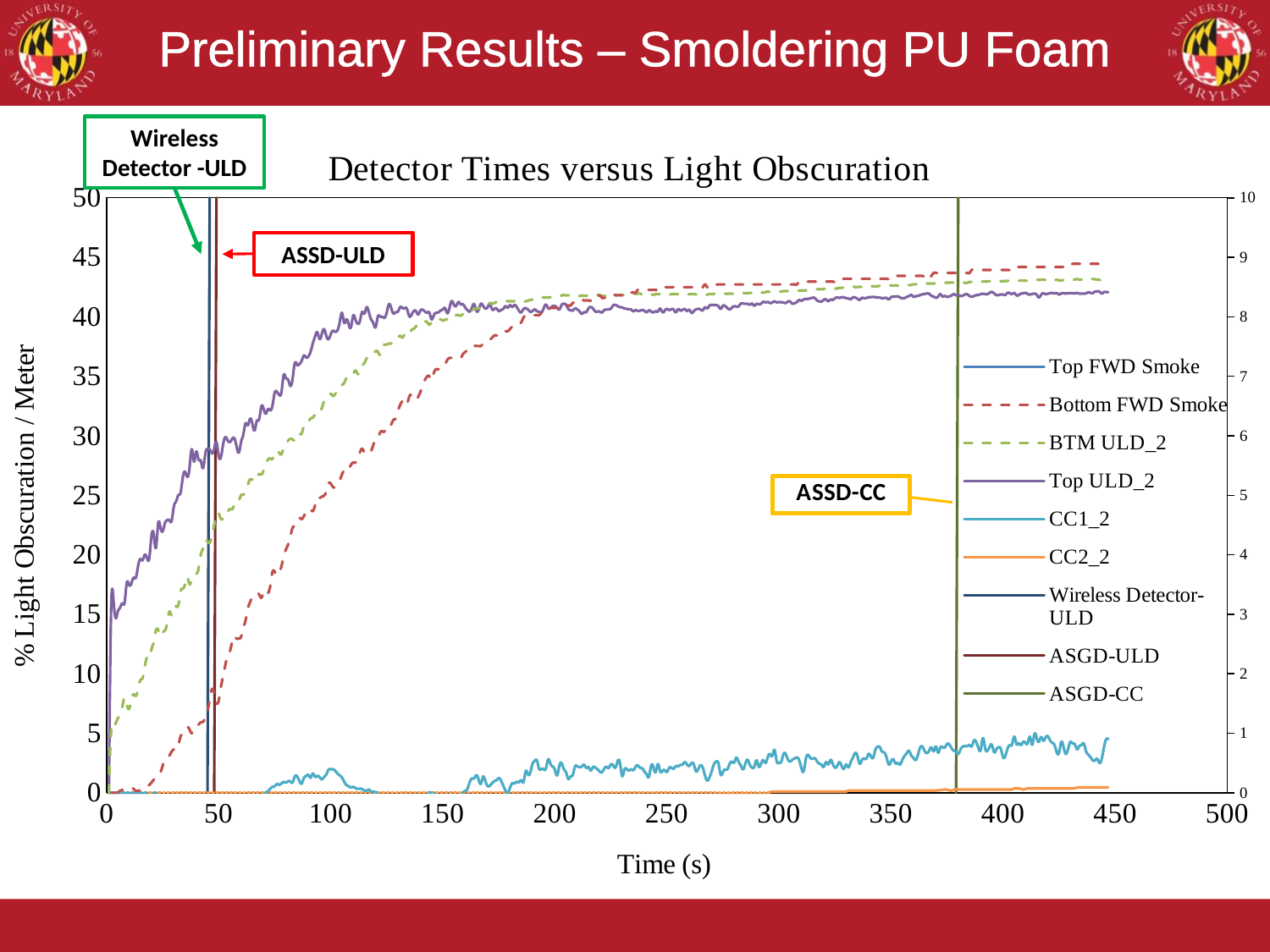
What is the label of the x axis? Time (s) Is the value of Top ULD_2 at 50 s greater or less than 25? greater Does the ASGD-CC vertical line occur at a time greater or less than 350 s? greater What kind of chart is shown on the slide? line chart Does the Top ULD_2 series generally rise or fall as time increases from 0 to 450 s? rise Is the value of Bottom FWD Smoke at 450 s greater or less than 40? greater At 100 s, which is larger: Top ULD_2 or Bottom FWD Smoke? Top ULD_2 How many series does the chart legend list? 9 What is the title of the chart? Detector Times versus Light Obscuration